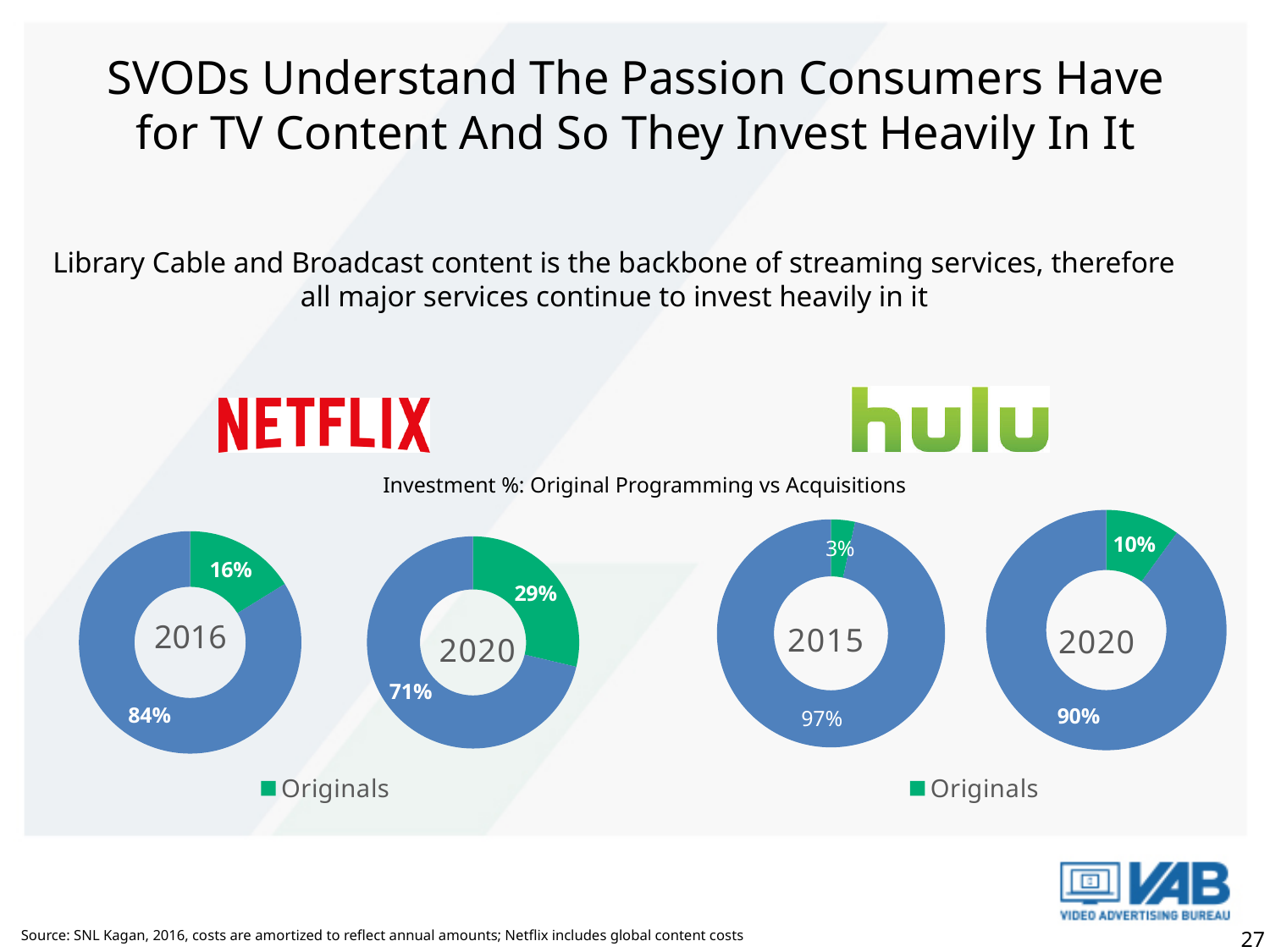
In the Hulu 2015 donut chart, what percentage is shown for the larger blue segment? 97% How many donut charts are shown on the slide? 4 In the Hulu 2020 donut chart, what percentage is labeled for Originals? 10% What type of chart is used to show the investment percentages on this slide? Donut (pie) chart By how many percentage points does the Originals share in the Netflix 2020 chart exceed the Originals share in the Netflix 2016 chart? 13 percentage points In the Hulu 2015 donut chart, what percentage is labeled for Originals? 3% Which chart shows a larger Originals share: Netflix 2020 or Hulu 2020? Netflix 2020 In the Netflix 2016 donut chart, what percentage is labeled for Originals? 16% In the Netflix 2020 donut chart, what percentage is labeled for Originals? 29% Across all four donut charts, which one shows the smallest Originals share? Hulu 2015 By how many percentage points does the Originals share in the Hulu 2020 chart exceed the Originals share in the Hulu 2015 chart? 7 percentage points In the Netflix 2016 donut chart, what percentage is shown for the larger blue segment? 84%